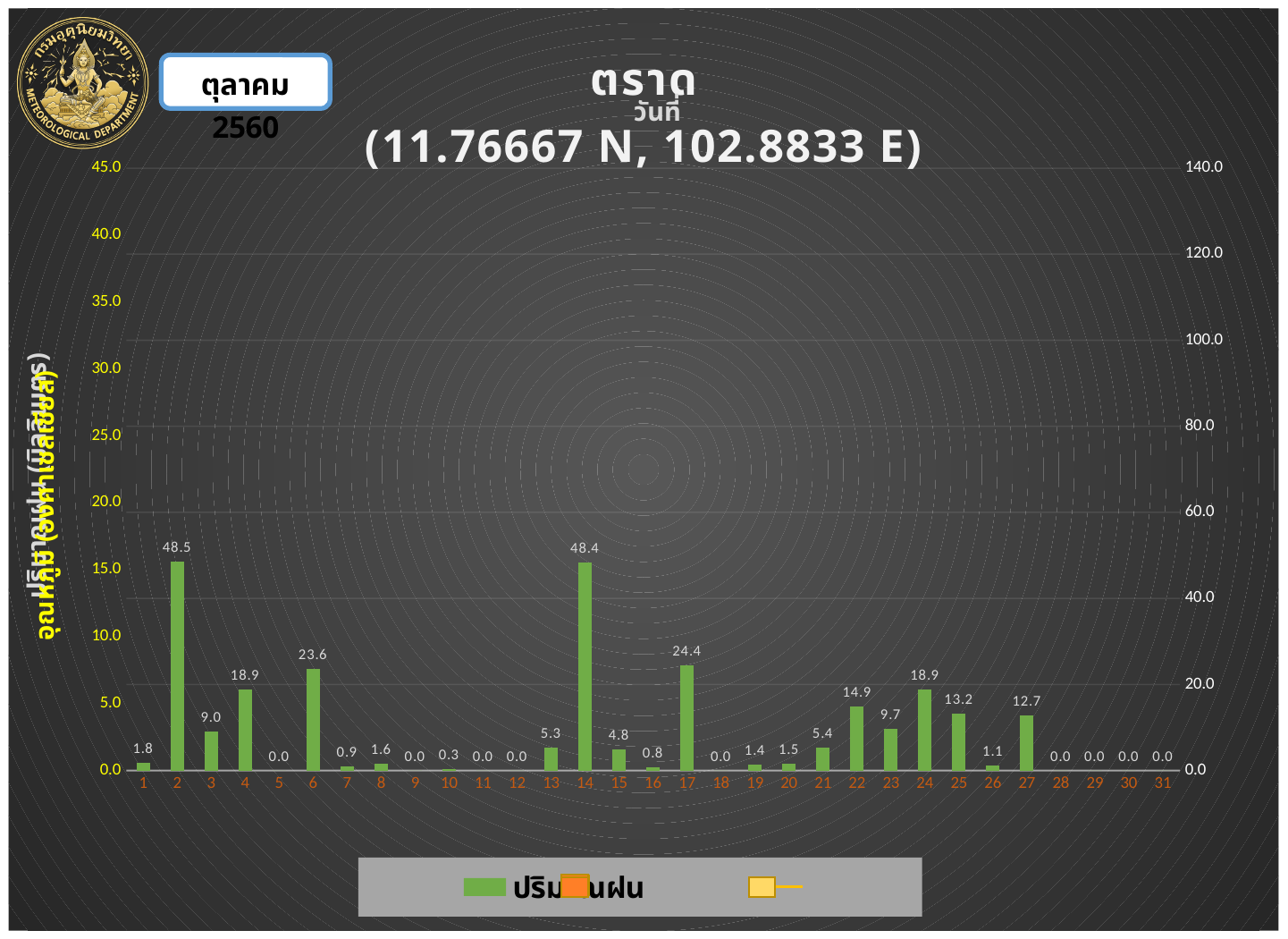
What is the value for day 27? 12.7 What is the difference between the values for day 4 and day 3? 9.9 What kind of chart is shown on the slide? Bar chart What is the title of the chart? ตราด (11.76667 N, 102.8833 E) What is the value for day 17? 24.4 What is the value for day 10? 0.3 What is the value for day 2? 48.5 How many days are shown on the x axis? 31 What is the value for day 14? 48.4 Which has the larger value, day 22 or day 23? Day 22 Which has the larger value, day 2 or day 17? Day 2 What is the difference between the values for day 22 and day 25? 1.7